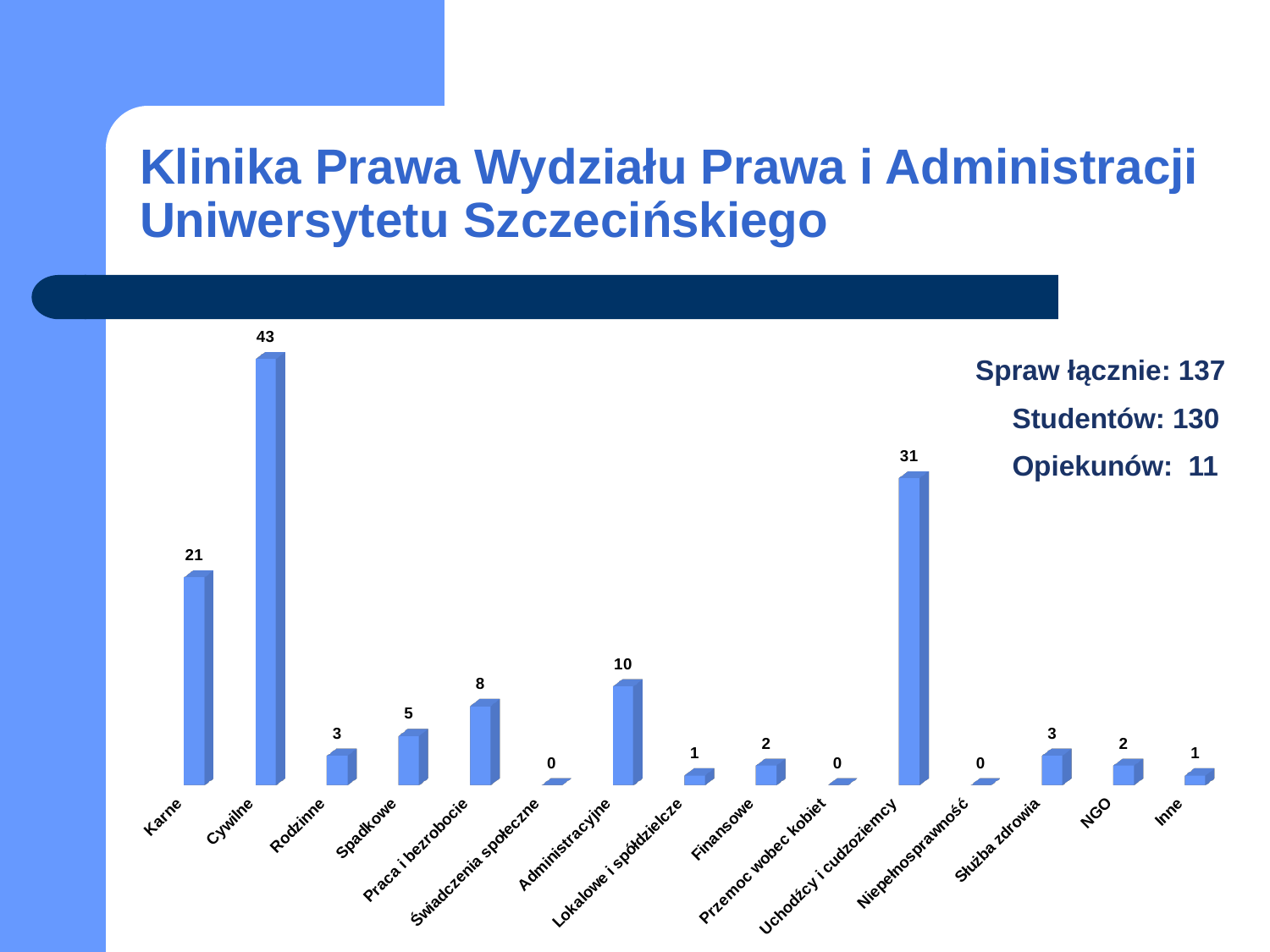
What is the value for Praca i bezrobocie? 8 Which is larger, the value for Spadkowe or the value for Rodzinne? Spadkowe What is the value for Uchodźcy i cudzoziemcy? 31 How many categories are shown on the x axis? 15 How many categories have a value of 0? 3 What kind of chart is shown on the slide? Bar chart Which category has the highest value? Cywilne What is the value for Administracyjne? 10 What is the difference between the values for Uchodźcy i cudzoziemcy and Administracyjne? 21 Which is larger, the value for Karne or the value for Uchodźcy i cudzoziemcy? Uchodźcy i cudzoziemcy What is the difference between the values for Cywilne and Karne? 22 What is the value for Cywilne? 43